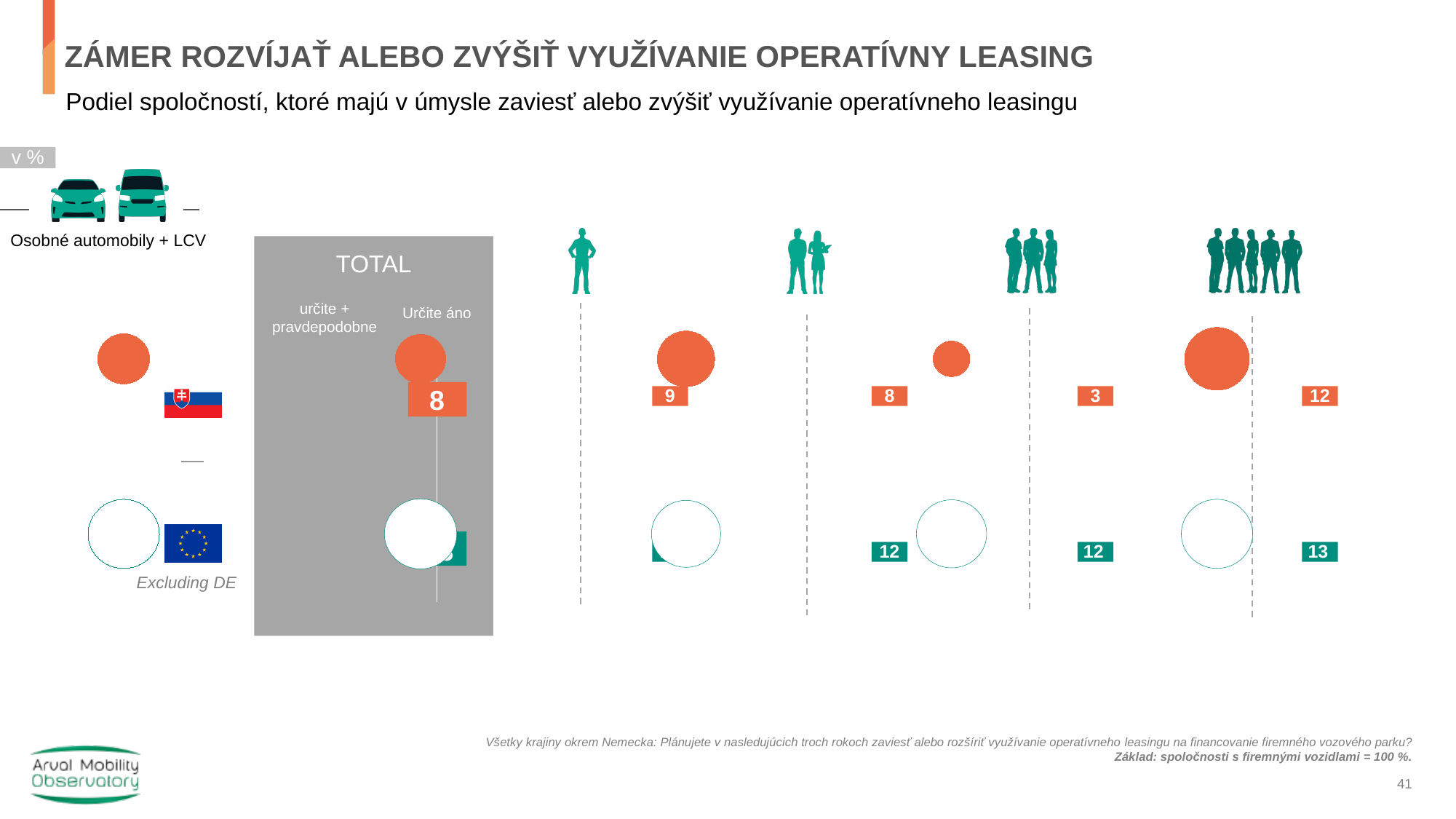
What is the Excluding DE 'Určite áno' value in the second company-size segment from the left? 12 What is the difference between the highest (12) and lowest (3) Slovakia 'Určite áno' segment values? 9 In the rightmost company-size segment, which is larger: the Slovakia value (12) or the Excluding DE value (13)? Excluding DE (13) What is the highest 'Určite áno' value shown for Slovakia (orange) across the four company-size segments? 12 What is the lowest 'Určite áno' value shown for Slovakia (orange) across the four company-size segments? 3 In the TOTAL box, what is the 'Určite áno' value shown for Slovakia (orange)? 8 What is the Slovakia 'Určite áno' value in the leftmost company-size segment (single person icon)? 9 What is the highest readable Excluding DE 'Určite áno' value across the company-size segments? 13 How many company-size segments (groups of people icons) are shown to the right of the TOTAL box? 4 What unit is indicated in the grey label at the top left of the chart? v % What are the two response categories named in the TOTAL box? určite + pravdepodobne; Určite áno In the third company-size segment from the left, what is the difference between the Excluding DE value (12) and the Slovakia value (3)? 9